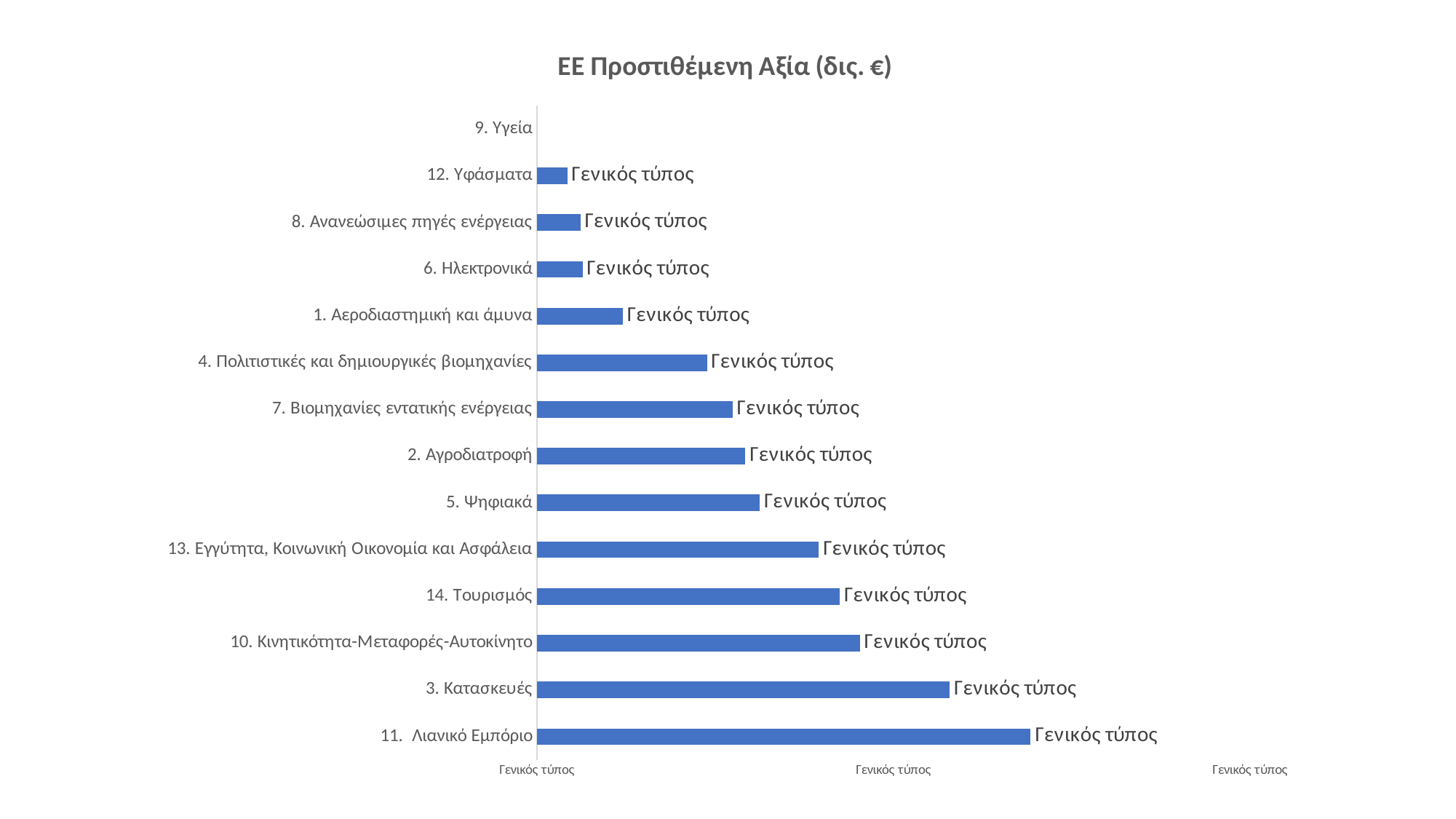
Which category has no visible bar at all? 9. Υγεία Do the bar lengths increase or decrease going from the top category to the bottom category? increase Which category has the longest bar? 11. Λιανικό Εμπόριο Which has the larger value, 3. Κατασκευές or 14. Τουρισμός? 3. Κατασκευές Which has the larger value, 10. Κινητικότητα-Μεταφορές-Αυτοκίνητο or 6. Ηλεκτρονικά? 10. Κινητικότητα-Μεταφορές-Αυτοκίνητο What kind of chart is shown on the slide? bar chart How many categories are listed on the chart? 14 Which category has the shortest visible bar? 12. Υφάσματα Which has the larger value, 1. Αεροδιαστημική και άμυνα or 4. Πολιτιστικές και δημιουργικές βιομηχανίες? 4. Πολιτιστικές και δημιουργικές βιομηχανίες What is the title of the chart? ΕΕ Προστιθέμενη Αξία (δις. €)